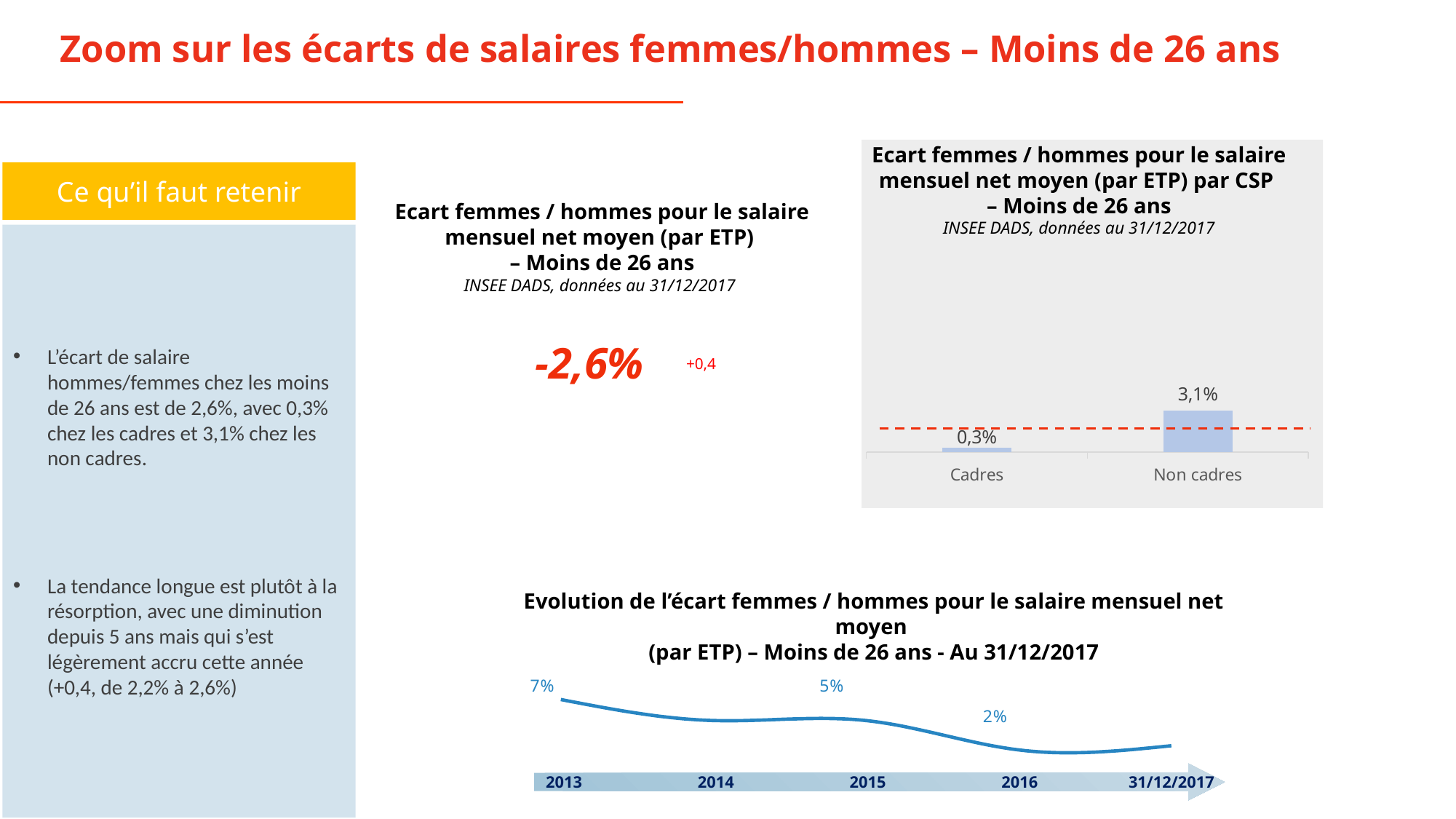
How many time points are labelled on the x axis of the 'Evolution de l'écart femmes / hommes' chart at the bottom? 5 In the bar chart by CSP (top right), which is larger: the value for Cadres or for Non cadres? Non cadres What kind of chart is the chart by CSP in the top right of the slide? Bar chart What kind of chart is the 'Evolution de l'écart femmes / hommes' chart at the bottom of the slide? Line chart In the 'Evolution de l'écart femmes / hommes' chart at the bottom, what is the value labelled for 2013? 7% How many categories are shown in the bar chart by CSP (top right)? 2 In the bar chart by CSP (top right), what is the difference between the values for Non cadres and Cadres? 2,8% In the bar chart by CSP (top right), which category has the lowest value? Cadres In the bar chart by CSP (top right), which category has the highest value? Non cadres In the 'Evolution de l'écart femmes / hommes' chart at the bottom, do the values rise or fall from 2013 to 31/12/2017? Fall In the bar chart 'Ecart femmes / hommes pour le salaire mensuel net moyen (par ETP) par CSP – Moins de 26 ans', what is the value for Non cadres? 3,1% In the bar chart 'Ecart femmes / hommes pour le salaire mensuel net moyen (par ETP) par CSP – Moins de 26 ans', what is the value for Cadres? 0,3%